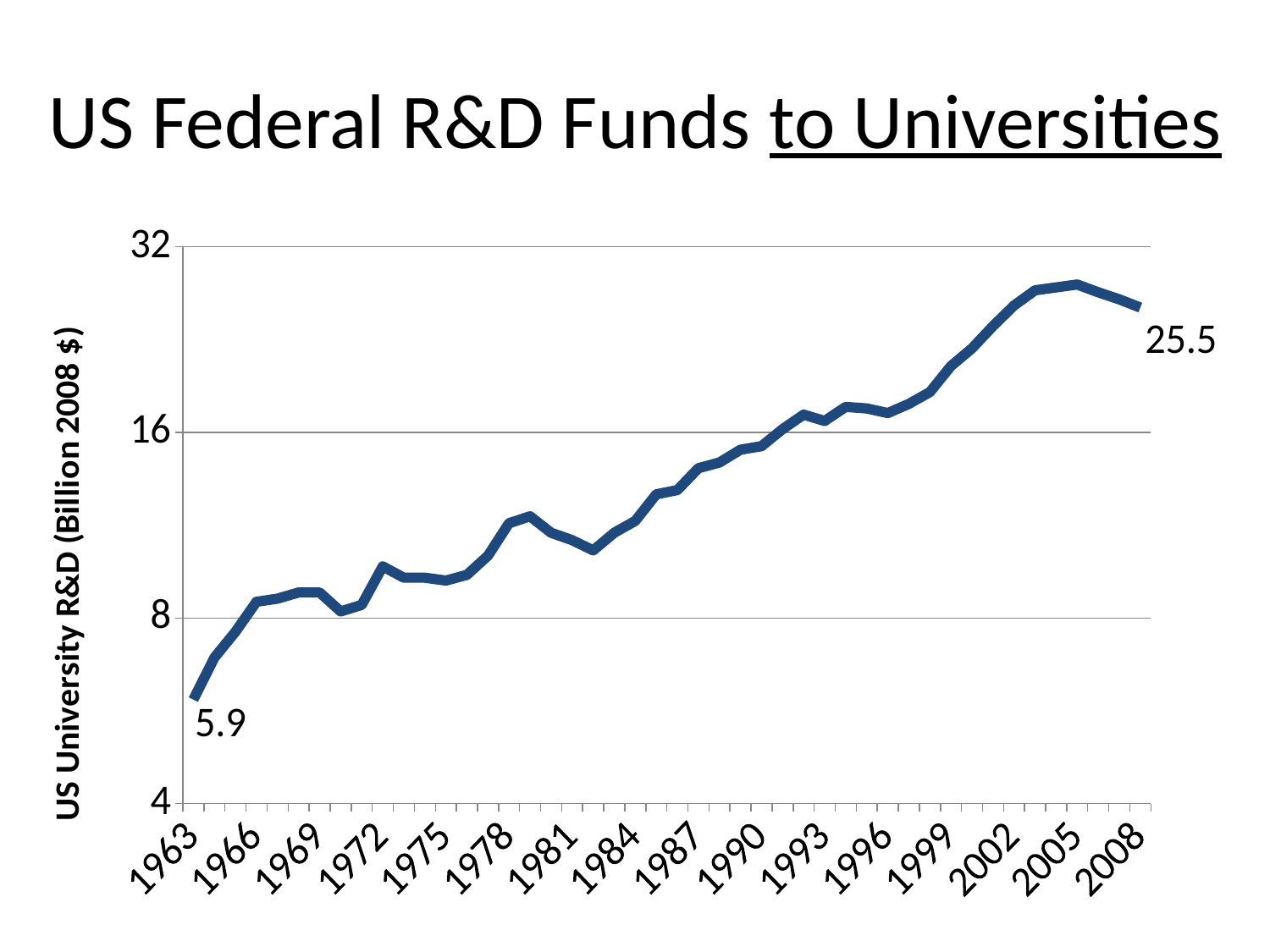
What is the title of the y axis? US University R&D (Billion 2008 $) What is the value for 1963? 5.9 How many year labels are shown on the x axis? 16 What is the difference between the 2008 value and the 1963 value? 19.6 What is the value for 2008? 25.5 Do the values generally rise or fall from 1963 to 2008? rise Is the value for 2005 greater or less than 16? greater Which year has the lowest value on the chart? 1963 What kind of chart is shown on the slide? line chart Which year has the larger value, 1963 or 2008? 2008 Is the value for 1975 greater or less than 8? greater Is the value for 1990 greater or less than 16? less